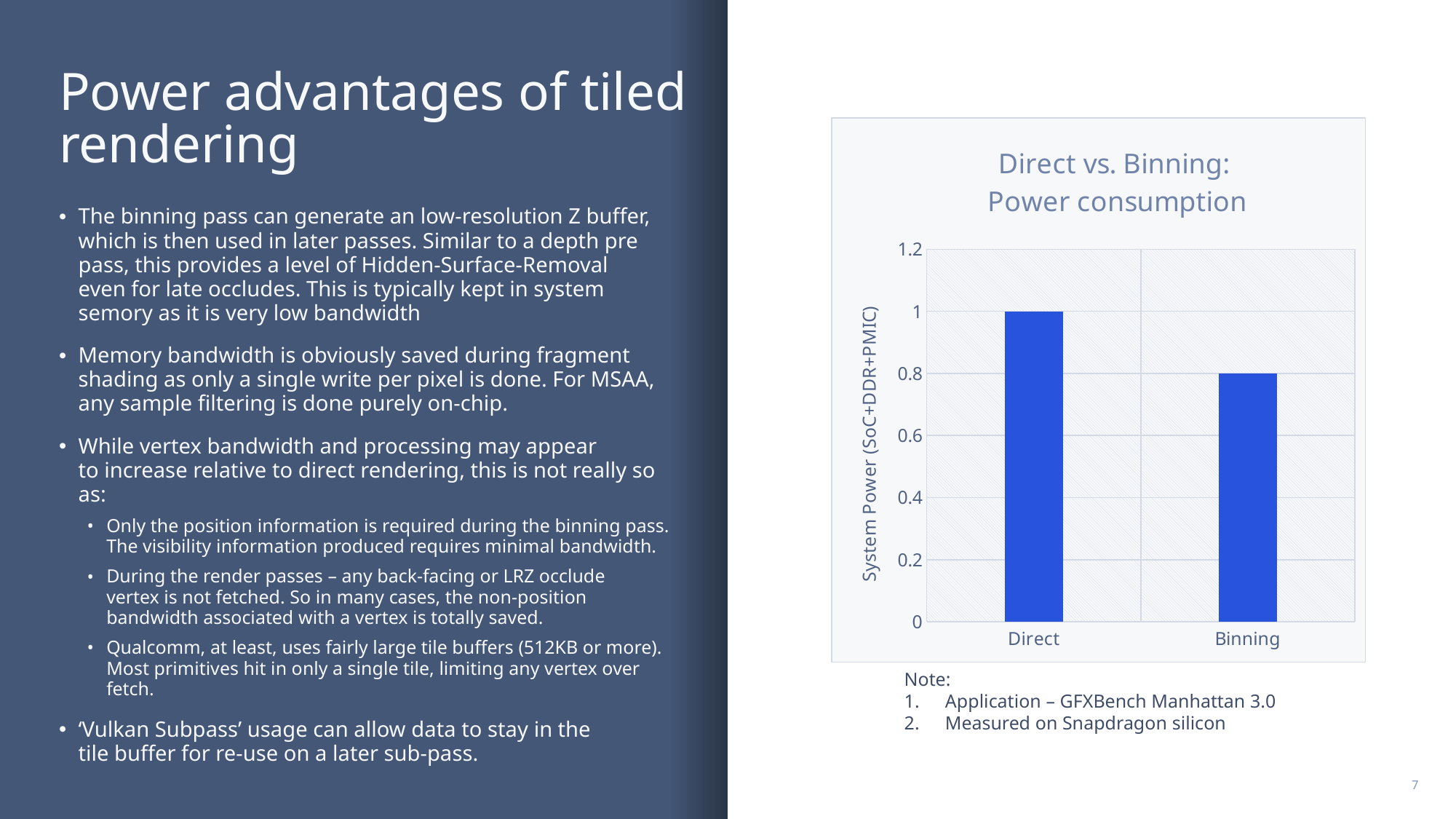
How many categories are plotted in the chart? 2 What is the difference in system power between Direct and Binning? 0.2 Which category has the highest system power? Direct Which category has the lowest system power? Binning What is the system power value for Direct? 1 Do the values rise or fall from Direct to Binning along the x axis? fall What is the title of the chart? Direct vs. Binning: Power consumption Is the value for Binning greater or less than 1? less Which has a larger system power value, Direct or Binning? Direct What is the system power value for Binning? 0.8 What type of chart is shown on the slide? bar chart What is the label of the vertical axis of the chart? System Power (SoC+DDR+PMIC)